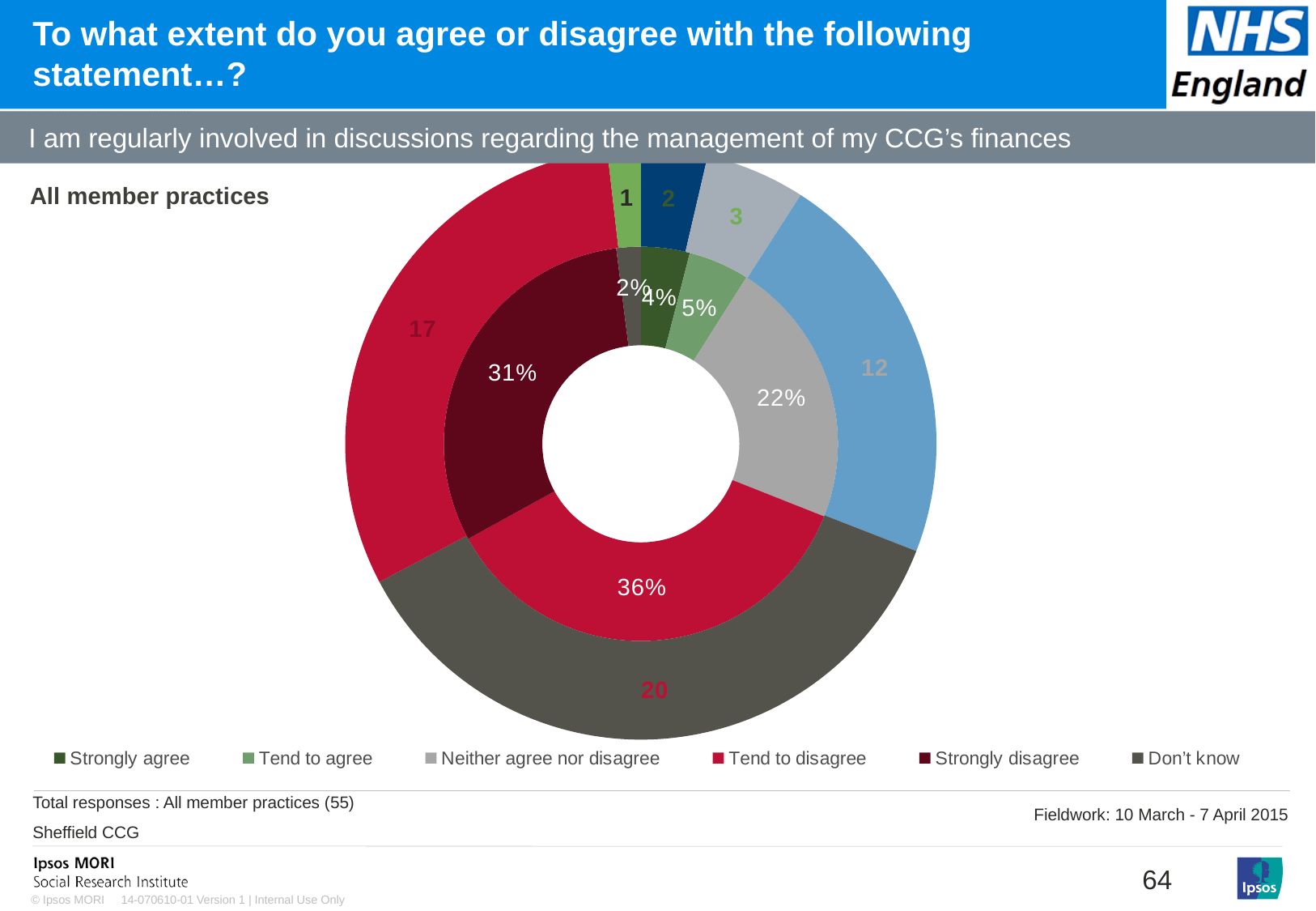
What percentage of member practices answered 'Don't know'? 2% What percentage of member practices answered 'Tend to disagree'? 36% What percentage of member practices answered 'Neither agree nor disagree'? 22% What percentage of member practices answered 'Tend to agree'? 5% How many categories does the legend list? 6 Which response category has the smallest share in the inner ring? Don't know What is the total of the counts shown in the outer ring of the chart? 55 What kind of chart is shown on the slide? Doughnut (pie) chart Which is larger: the share for 'Neither agree nor disagree' or the share for 'Strongly agree'? Neither agree nor disagree Which response category has the largest share in the inner ring? Tend to disagree What is the difference in percentage points between 'Tend to disagree' and 'Strongly disagree'? 5 percentage points What percentage of member practices answered 'Strongly disagree'? 31%